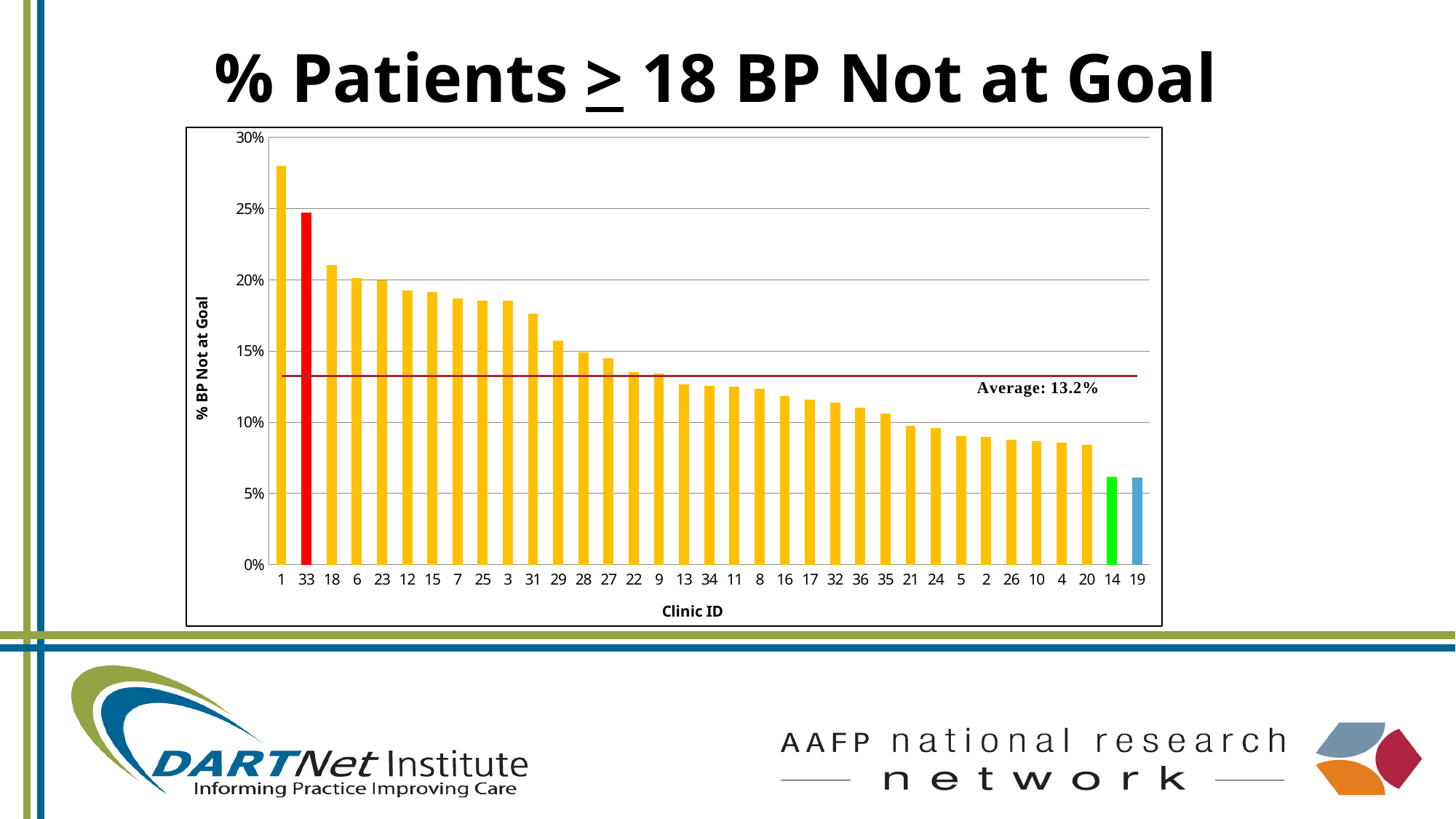
What kind of chart is shown on the slide? bar chart How many clinics are plotted on the x axis? 35 Is the value for clinic 20 greater or less than 10%? less Do the bar values rise or fall moving from left to right along the x axis? fall What average value is labelled on the horizontal line in the chart? 13.2% Which has a higher % BP Not at Goal, clinic 1 or clinic 33? clinic 1 Is the value for clinic 1 greater or less than 25%? greater Is the value for clinic 9 greater or less than 15%? less Which clinic ID is shown with a red bar? 33 Which clinic ID has the highest % BP Not at Goal? 1